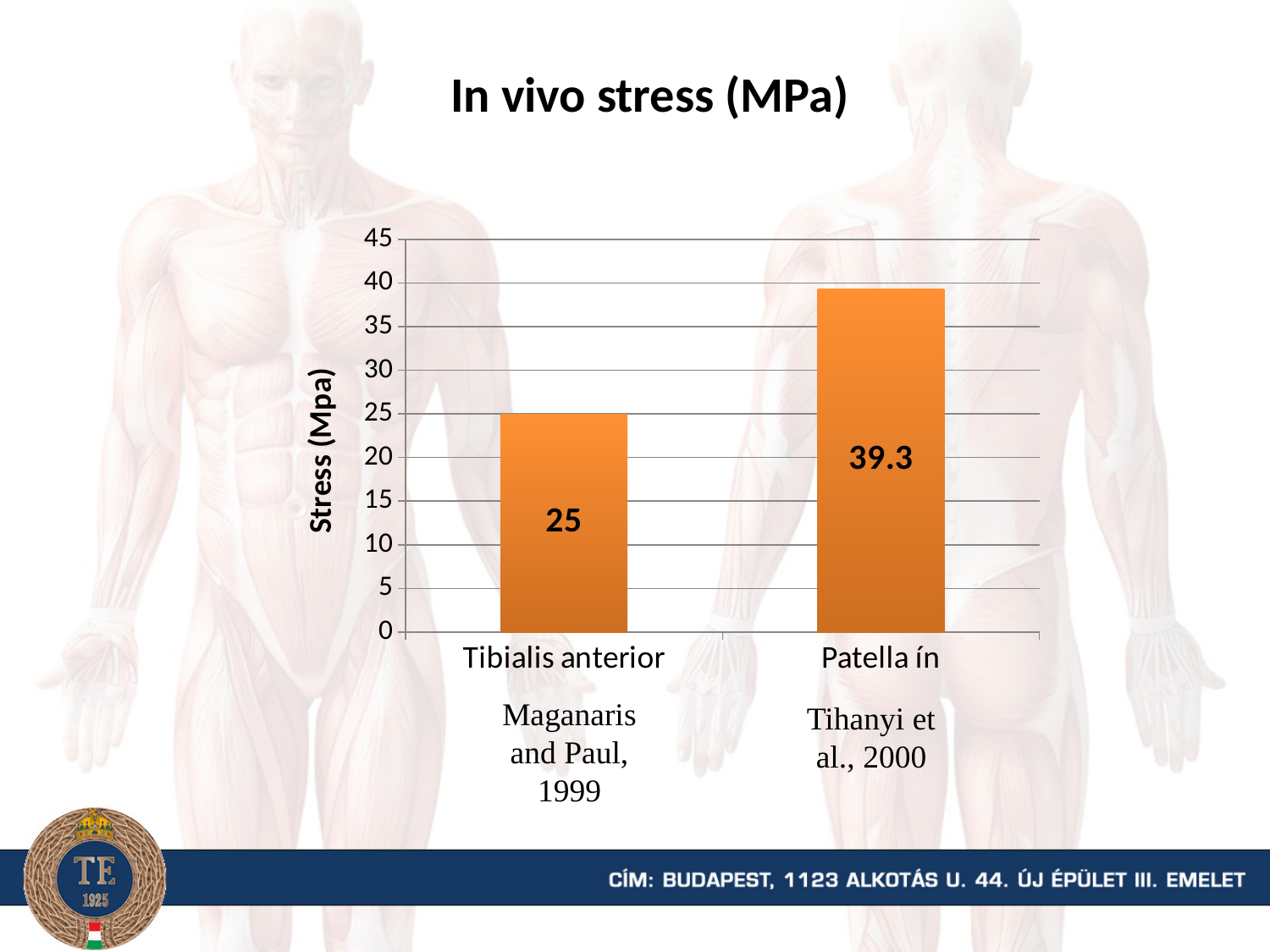
Which category has the lowest stress value? Tibialis anterior Is the value for Tibialis anterior greater or less than 30? less What is the in vivo stress value for Tibialis anterior? 25 How many categories are shown in the chart? 2 What kind of chart is shown on the slide? bar chart What is the in vivo stress value for Patella ín? 39.3 Is the value for Patella ín greater or less than 35? greater What is the difference between the stress values for Patella ín and Tibialis anterior? 14.3 What is the title of the chart? In vivo stress (MPa) What is the label of the vertical axis? Stress (Mpa) Which category has the highest stress value? Patella ín Which is larger, the stress value for Tibialis anterior or for Patella ín? Patella ín